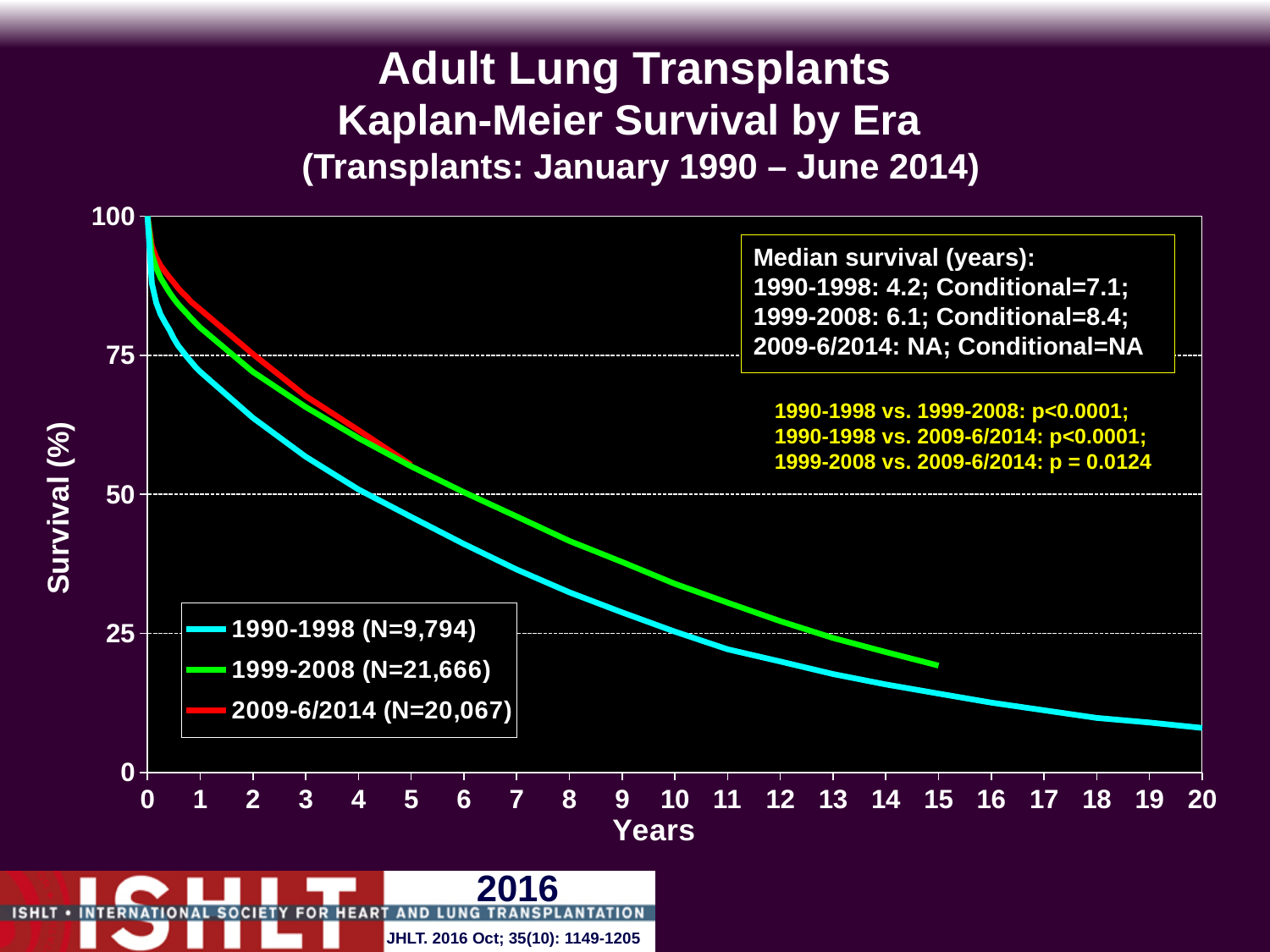
What kind of chart is shown on the slide? line chart At 5 years, is the survival for the 1990-1998 era greater or less than 50%? less Which era has the higher median survival, 1990-1998 or 1999-2008? 1999-2008 At 1 year, is the survival for the 2009-6/2014 era greater or less than 75%? greater How many series (eras) does the legend list? 3 What is the median survival in years for the 1990-1998 era? 4.2 At 5 years, which era has higher survival, 1990-1998 or 1999-2008? 1999-2008 Which era's survival curve extends furthest along the Years axis? 1990-1998 Do the survival curves rise or fall as years since transplant increase? fall According to the legend, what is the N for the 1999-2008 era? 21,666 What is the conditional median survival in years for the 1999-2008 era? 8.4 What is the difference in median survival (years) between the 1999-2008 era and the 1990-1998 era? 1.9